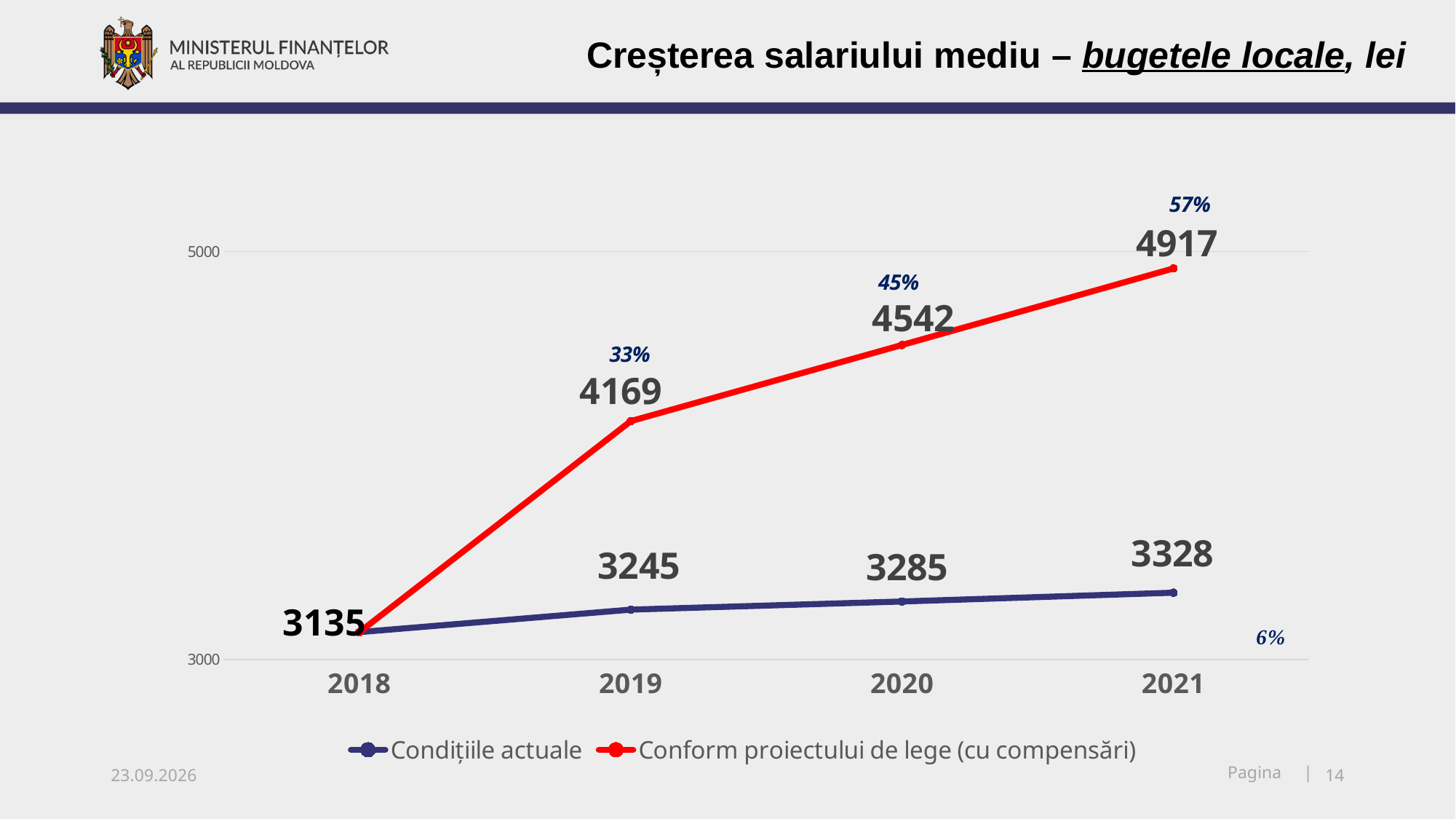
What is the value for 'Conform proiectului de lege (cu compensări)' in 2021? 4917 In which year does 'Conform proiectului de lege (cu compensări)' reach its highest value? 2021 Which series has the larger value in 2020? Conform proiectului de lege (cu compensări) What is the value for 'Condițiile actuale' in 2020? 3285 What is the difference between the two series in 2021 (4917 and 3328)? 1589 What type of chart is shown on the slide? line chart What is the value in 2018, where both series start? 3135 What colour is the line for 'Conform proiectului de lege (cu compensări)'? red How many series does the legend list? 2 Do the values for 'Condițiile actuale' rise or fall from 2018 to 2021? rise What is the value for 'Conform proiectului de lege (cu compensări)' in 2019? 4169 How many years are shown on the x axis? 4